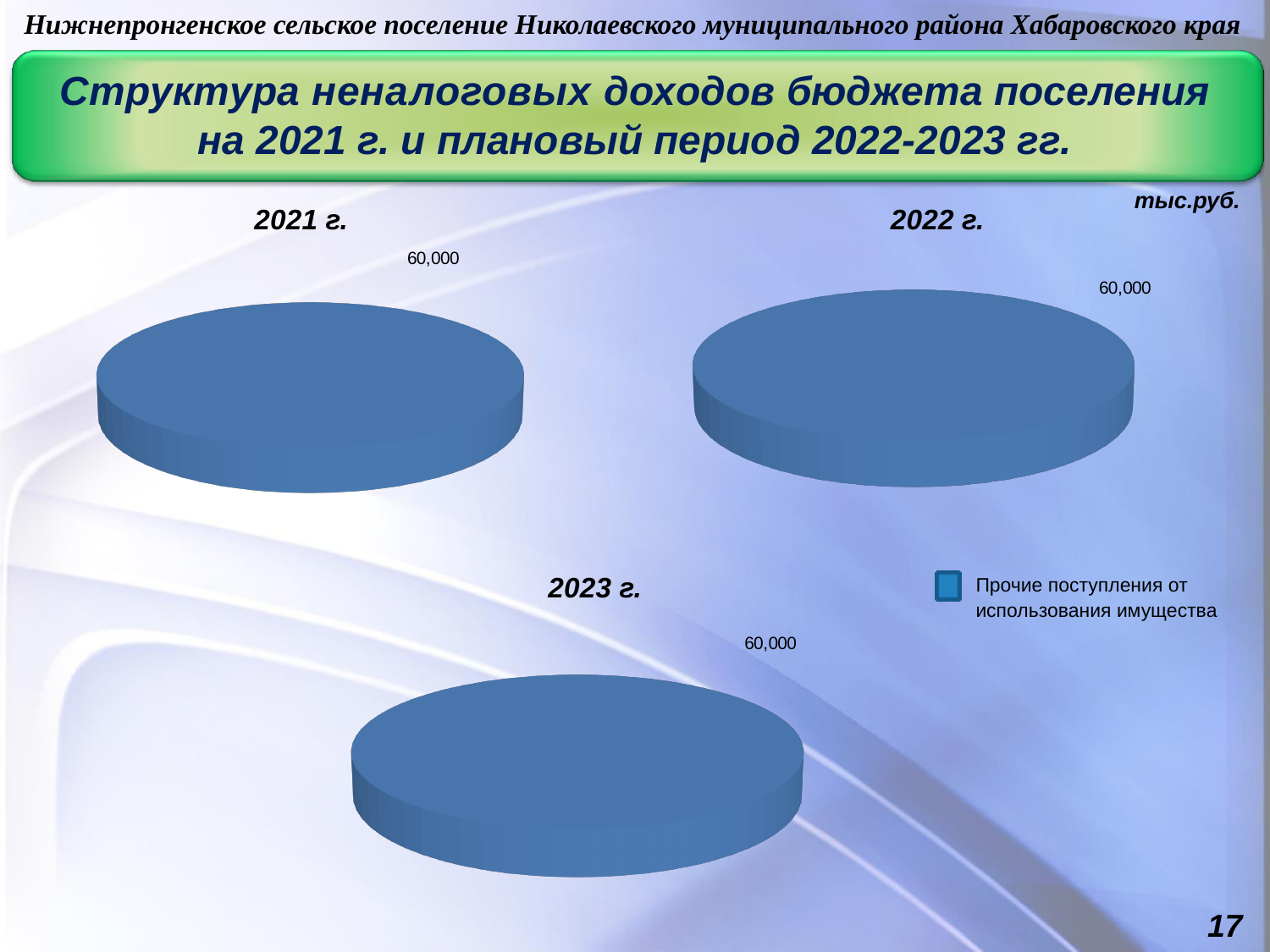
How many slices does the 2022 г. pie chart have? 1 In the 2023 г. chart, what value is shown for Прочие поступления от использования имущества? 60,000 What kind of chart is the 2023 г. chart? pie chart How many entries does the legend list? 1 How many pie charts are on the slide? 3 In the 2022 г. chart, what value is shown for Прочие поступления от использования имущества? 60,000 What share of the 2021 г. pie does Прочие поступления от использования имущества take? 100% What kind of chart is the 2021 г. chart? pie chart In what units are the chart values given, according to the slide? тыс.руб. What is the difference between the 2022 г. value and the 2021 г. value for Прочие поступления от использования имущества? 0 In the 2021 г. chart, what value is shown for Прочие поступления от использования имущества? 60,000 What is the legend entry shown on the slide? Прочие поступления от использования имущества